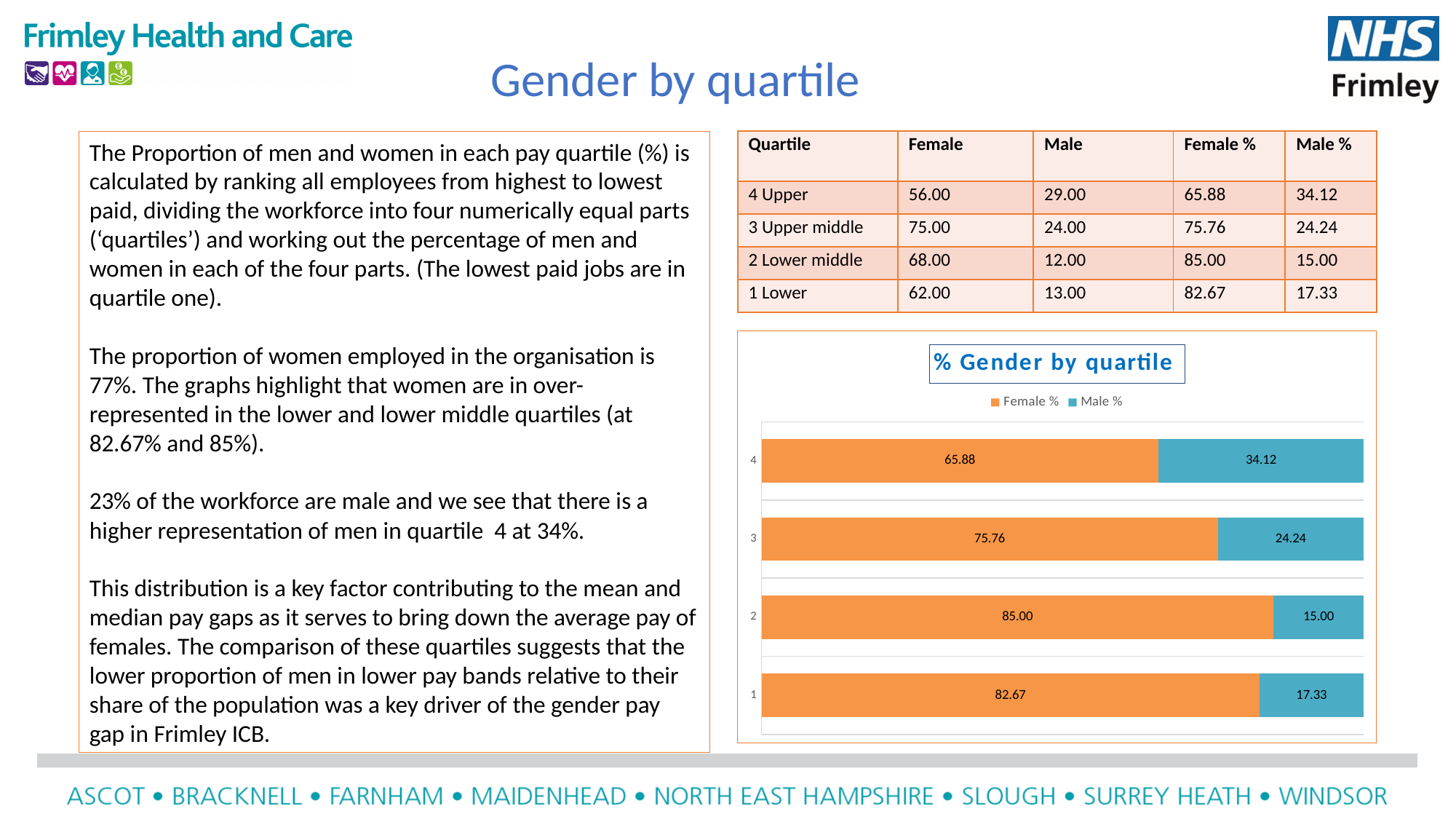
Which quartile has the lowest Male % in the % Gender by quartile chart? 2 Is the Female % for quartile 1 larger or the Female % for quartile 4 in the % Gender by quartile chart? quartile 1 What type of chart is the % Gender by quartile chart? Stacked bar chart Which quartile has the highest Male % in the % Gender by quartile chart? 4 What is the Male % value for quartile 1 in the % Gender by quartile chart? 17.33 Which colour represents Male % in the % Gender by quartile chart? Blue How many series does the legend of the % Gender by quartile chart list? 2 What is the difference between the Female % and Male % for quartile 3 in the % Gender by quartile chart? 51.52 How many quartiles are shown in the % Gender by quartile chart? 4 Which quartile has the highest Female % in the % Gender by quartile chart? 2 What is the Male % value for quartile 2 in the % Gender by quartile chart? 15.00 What is the Female % value for quartile 4 in the % Gender by quartile chart? 65.88